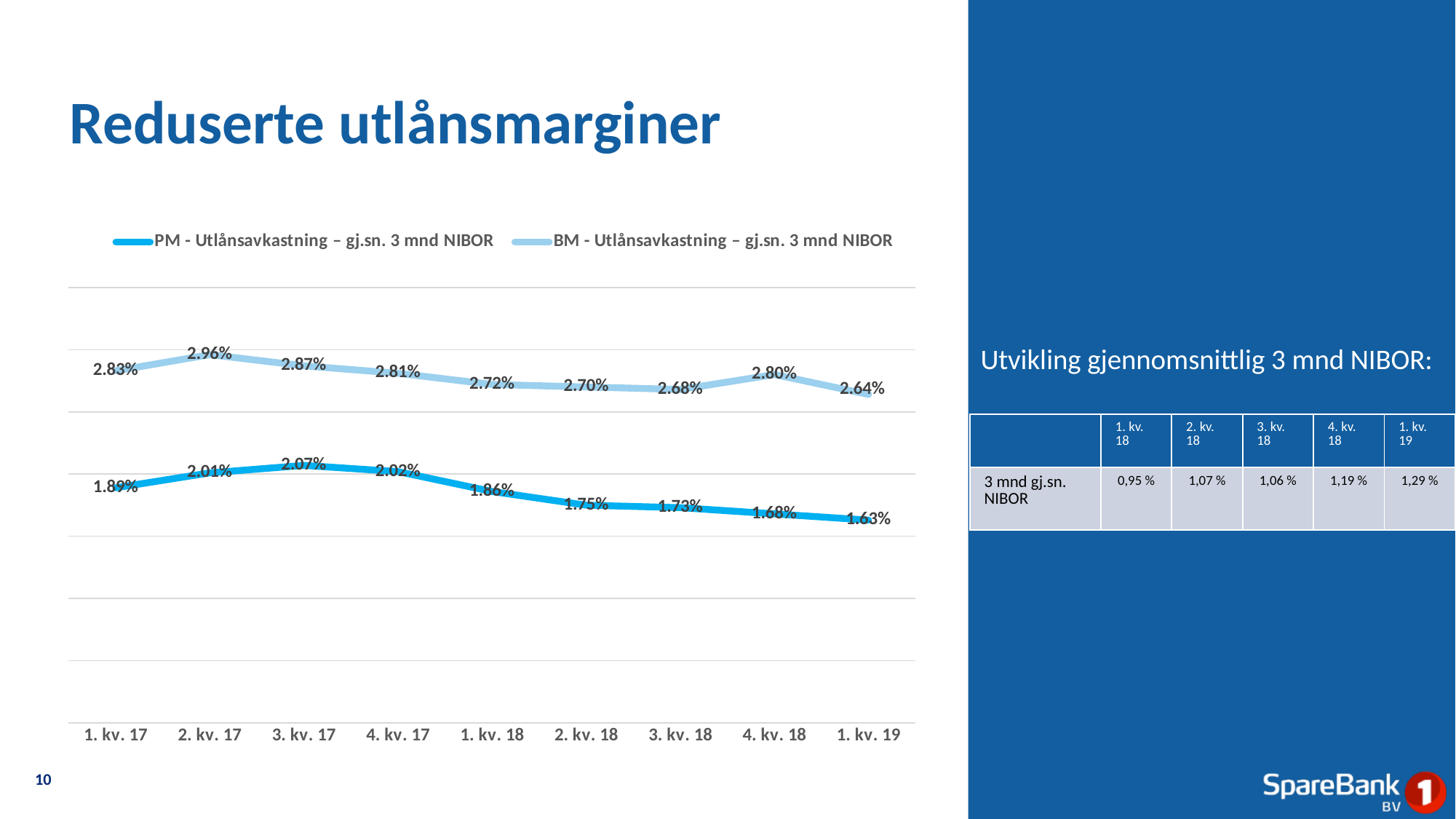
How many series does the chart legend list? 2 In which quarter does the PM - Utlånsavkastning – gj.sn. 3 mnd NIBOR series reach its lowest value? 1. kv. 19 What is the difference between the BM and PM values in 1. kv. 19? 1.01 percentage points How many quarters are plotted along the x axis of the chart? 9 Which series has the higher value in 4. kv. 18, PM or BM? BM In which quarter does the BM - Utlånsavkastning – gj.sn. 3 mnd NIBOR series reach its highest value? 2. kv. 17 What is the value of PM - Utlånsavkastning – gj.sn. 3 mnd NIBOR in 3. kv. 17? 2.07% By how much did the PM - Utlånsavkastning – gj.sn. 3 mnd NIBOR value fall from 3. kv. 17 to 1. kv. 19? 0.44 percentage points What type of chart is shown on the slide? line chart What is the value of BM - Utlånsavkastning – gj.sn. 3 mnd NIBOR in 1. kv. 18? 2.72% Does the PM - Utlånsavkastning – gj.sn. 3 mnd NIBOR series rise or fall from 4. kv. 17 to 1. kv. 19? fall What is the value of PM - Utlånsavkastning – gj.sn. 3 mnd NIBOR in 1. kv. 19? 1.63%